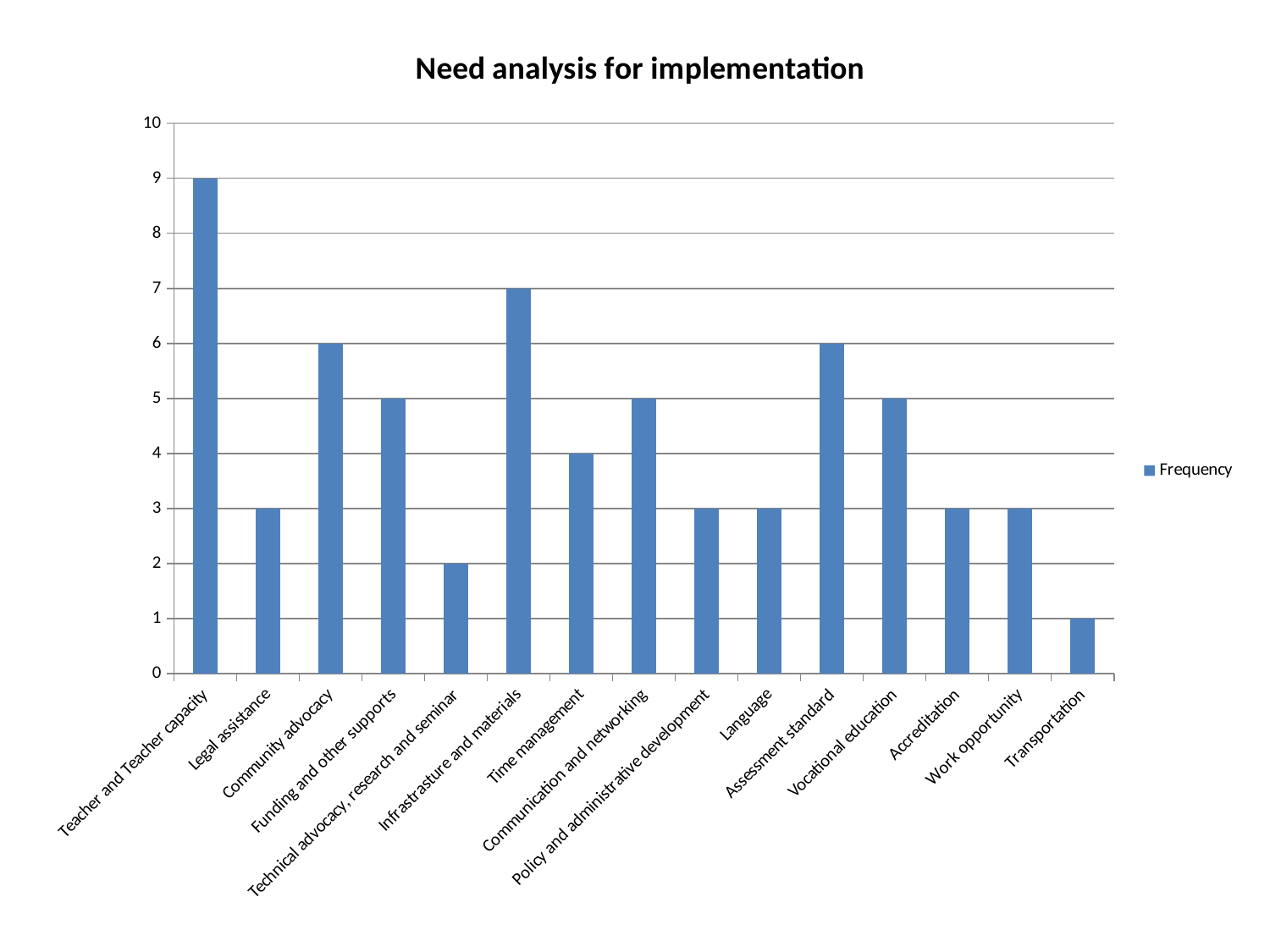
Is the Frequency for Assessment standard greater or less than 5? greater Which category has the lowest Frequency? Transportation What is the Frequency value for Teacher and Teacher capacity? 9 Which category has the highest Frequency? Teacher and Teacher capacity What is the Frequency value for Time management? 4 What is the title of the chart? Need analysis for implementation Which has a higher Frequency, Community advocacy or Funding and other supports? Community advocacy How many categories are shown on the x axis? 15 What kind of chart is shown on the slide? bar chart What is the Frequency value for Infrastrasture and materials? 7 What is the difference in Frequency between Teacher and Teacher capacity and Infrastrasture and materials? 2 How many series does the legend list? 1